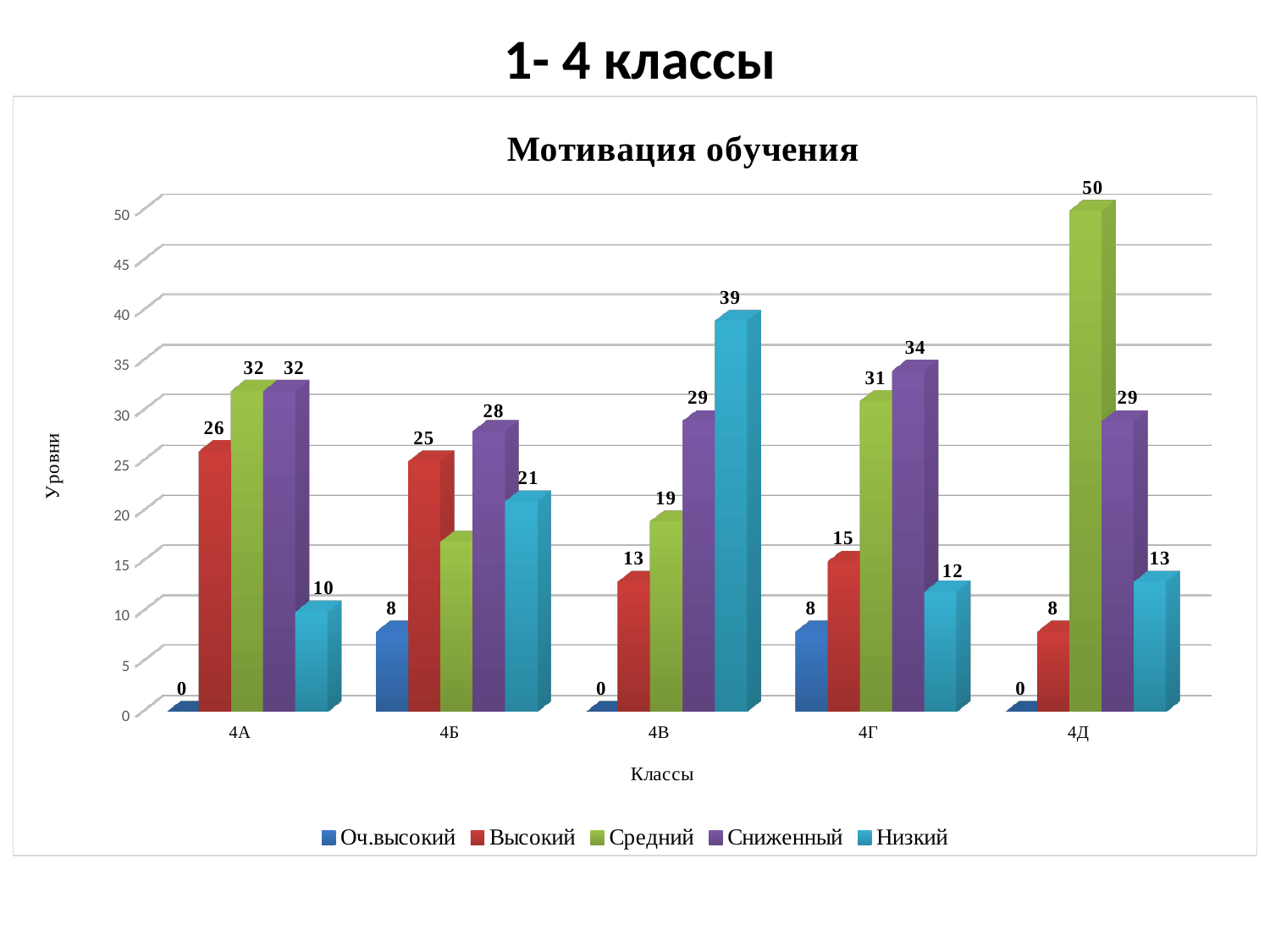
What is the value of Оч.высокий for class 4Г? 8 Which class has the highest value for Сниженный? 4Г Is the value of Средний for class 4Б greater or less than 20? less Which class has the lowest value for Высокий? 4Д What kind of chart is shown on the slide? bar chart How many series does the legend list? 5 What is the title of the chart? Мотивация обучения Which class has the larger Низкий value, 4Б or 4Д? 4Б What is the value of Средний for class 4Д? 50 What is the difference between the Средний values for 4Д and 4Г? 19 What is the value of Низкий for class 4В? 39 How many classes are shown on the x axis? 5